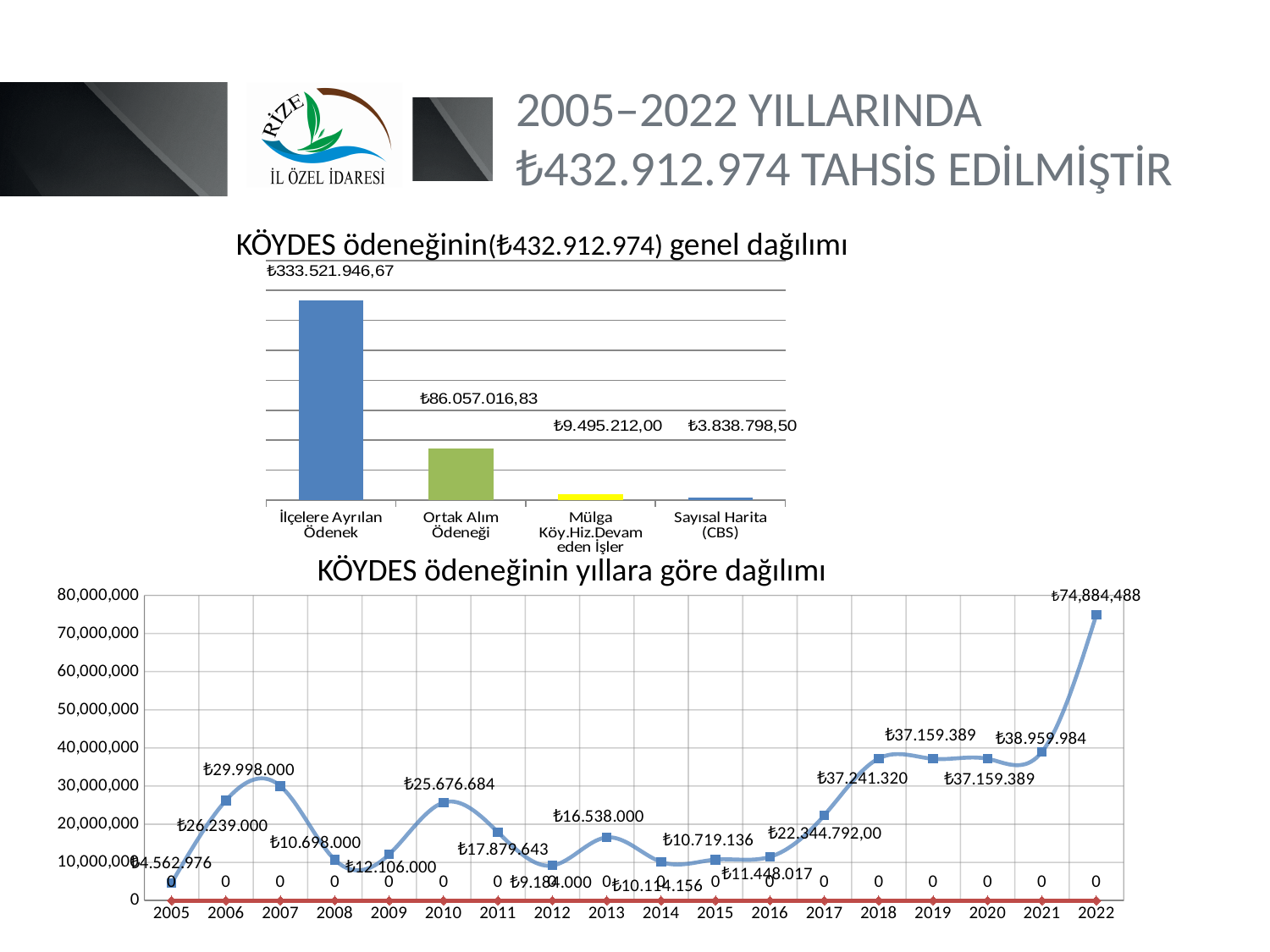
How many years are shown on the x axis of the bottom chart 'KÖYDES ödeneğinin yıllara göre dağılımı'? 18 In the bottom chart 'KÖYDES ödeneğinin yıllara göre dağılımı', which is larger, the value for 2006 or the value for 2009? 2006 In the top chart 'KÖYDES ödeneğinin genel dağılımı', which category has the lowest value? Sayısal Harita (CBS) In the top chart 'KÖYDES ödeneğinin genel dağılımı', which category has the highest value? İlçelere Ayrılan Ödenek In the top chart 'KÖYDES ödeneğinin genel dağılımı', what is the value for Ortak Alım Ödeneği? ₺86.057.016,83 In the top chart 'KÖYDES ödeneğinin genel dağılımı', what is the value for Sayısal Harita (CBS)? ₺3.838.798,50 In the bottom chart 'KÖYDES ödeneğinin yıllara göre dağılımı', what is the value for 2007? ₺29.998.000 In the bottom chart 'KÖYDES ödeneğinin yıllara göre dağılımı', is the value for 2022 greater or less than 70,000,000? greater In the bottom chart 'KÖYDES ödeneğinin yıllara göre dağılımı', which year has the highest value? 2022 How many categories are shown in the top chart 'KÖYDES ödeneğinin genel dağılımı'? 4 In the bottom chart 'KÖYDES ödeneğinin yıllara göre dağılımı', what is the value for 2022? ₺74,884,488 What kind of chart is the top chart 'KÖYDES ödeneğinin genel dağılımı'? Bar chart